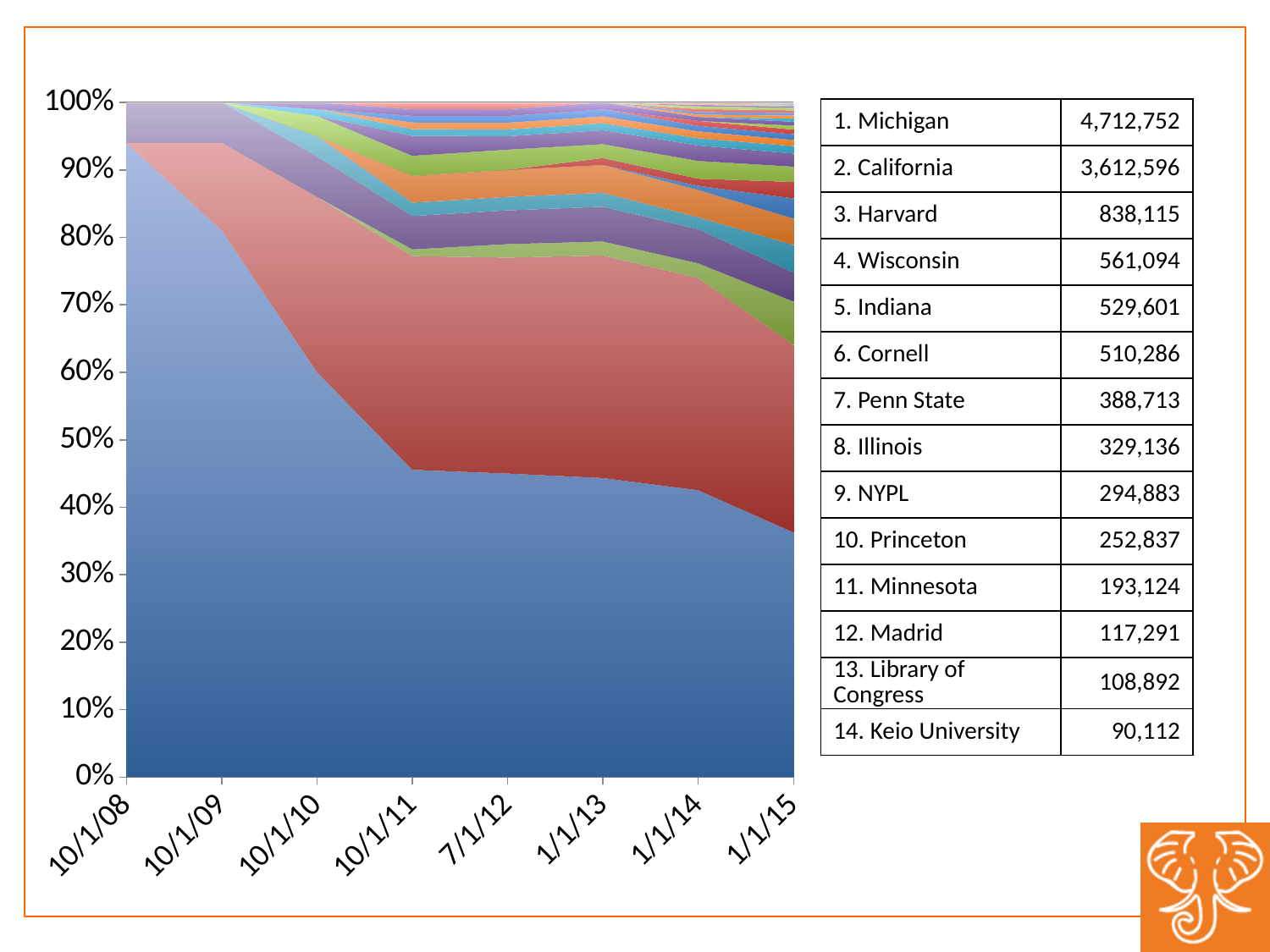
How many dates are labelled along the x axis of the chart? 8 What kind of chart is shown on the slide? Stacked area chart What is the highest value shown on the y axis of the chart? 100% Is the share of the bottom blue area at 10/1/08 greater or less than 90%? greater Is the share of the bottom blue area at 10/1/11 greater or less than 50%? less What is the first date labelled on the x axis of the chart? 10/1/08 What is the last date labelled on the x axis of the chart? 1/1/15 At which labelled date is the share of the bottom blue area the smallest? 1/1/15 Does the share of the bottom blue area rise or fall from 10/1/08 to 1/1/15? Fall Is the share of the bottom blue area at 10/1/10 greater or less than 50%? greater At which labelled date is the share of the bottom blue area the largest? 10/1/08